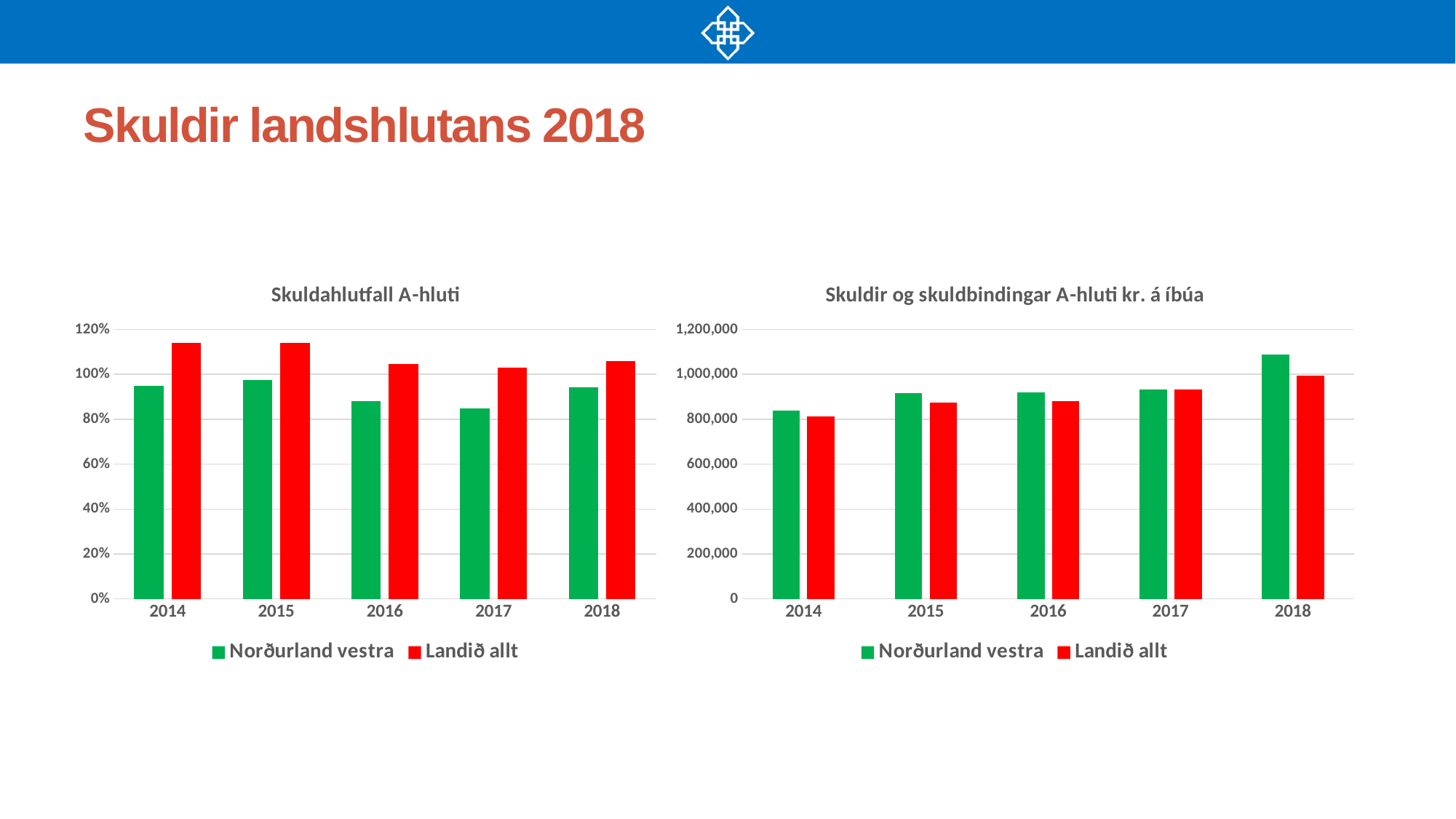
In the left chart "Skuldahlutfall A-hluti", how many years are shown on the x axis? 5 In the right chart "Skuldir og skuldbindingar A-hluti kr. á íbúa", in which year is the Norðurland vestra value highest? 2018 In the left chart "Skuldahlutfall A-hluti", how many series does the legend list? 2 In the left chart "Skuldahlutfall A-hluti", is the value for Landið allt in 2014 greater or less than 100%? greater In the right chart "Skuldir og skuldbindingar A-hluti kr. á íbúa", which series has the larger value in 2018, Norðurland vestra or Landið allt? Norðurland vestra What kind of chart is the left chart titled "Skuldahlutfall A-hluti"? Bar chart In the right chart "Skuldir og skuldbindingar A-hluti kr. á íbúa", is the value for Norðurland vestra in 2018 greater or less than 1,000,000? greater In the left chart "Skuldahlutfall A-hluti", which series has the larger value in 2016, Norðurland vestra or Landið allt? Landið allt In the right chart "Skuldir og skuldbindingar A-hluti kr. á íbúa", do the Norðurland vestra values rise or fall from 2014 to 2018? rise In the left chart "Skuldahlutfall A-hluti", in which year is the Norðurland vestra value lowest? 2017 In the left chart "Skuldahlutfall A-hluti", is the value for Norðurland vestra in 2017 greater or less than 100%? less